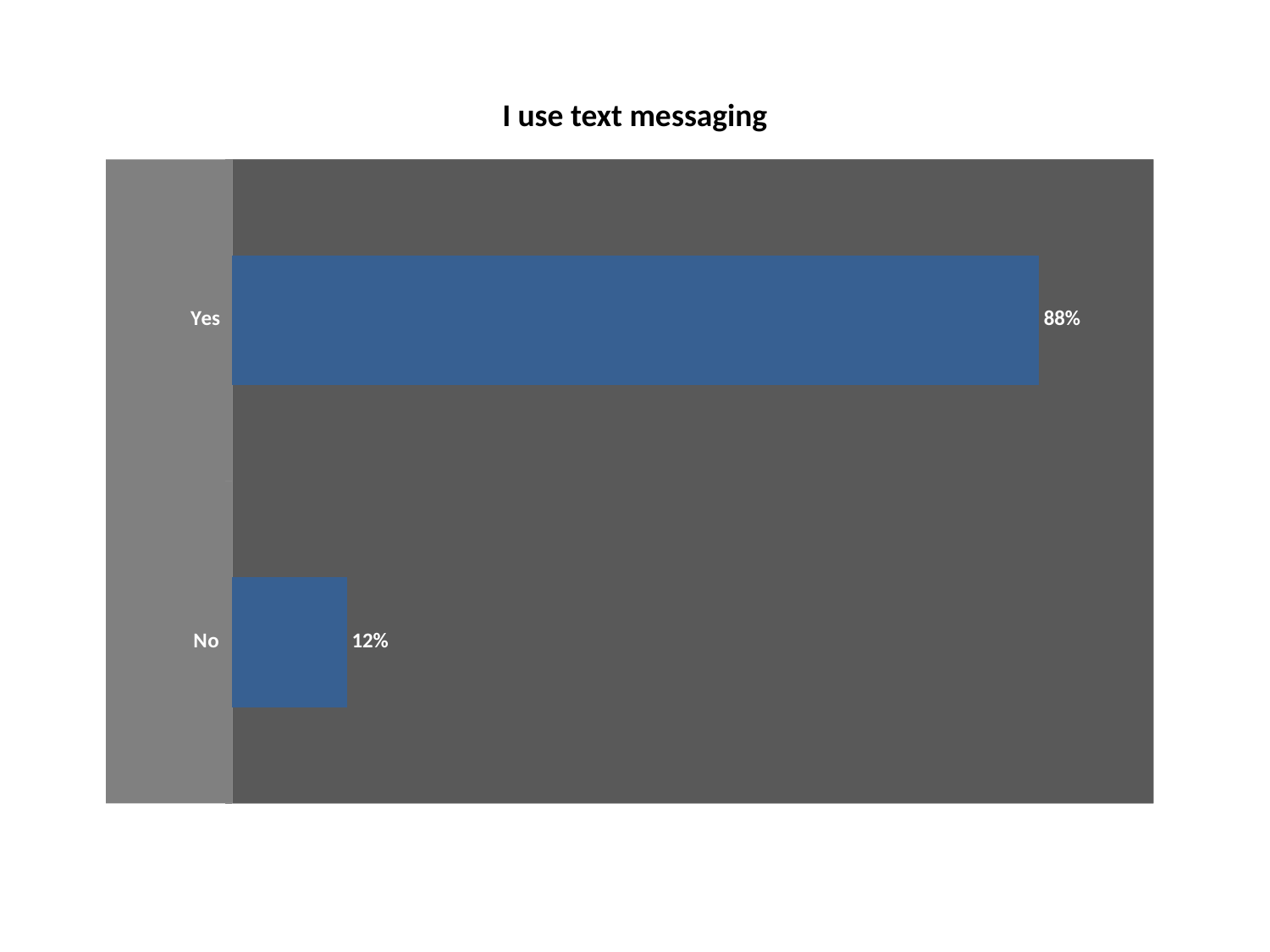
What is the difference between the values for Yes and No? 76% What is the total of the values for Yes and No? 100% How many categories are shown in the chart? 2 Which category has the highest value? Yes What is the title of the chart? I use text messaging What kind of chart is shown on the slide? bar chart What is the value for Yes? 88% Which is larger, the value for Yes or the value for No? Yes What colour are the bars in the chart? blue What is the value for No? 12% Which category has the lowest value? No